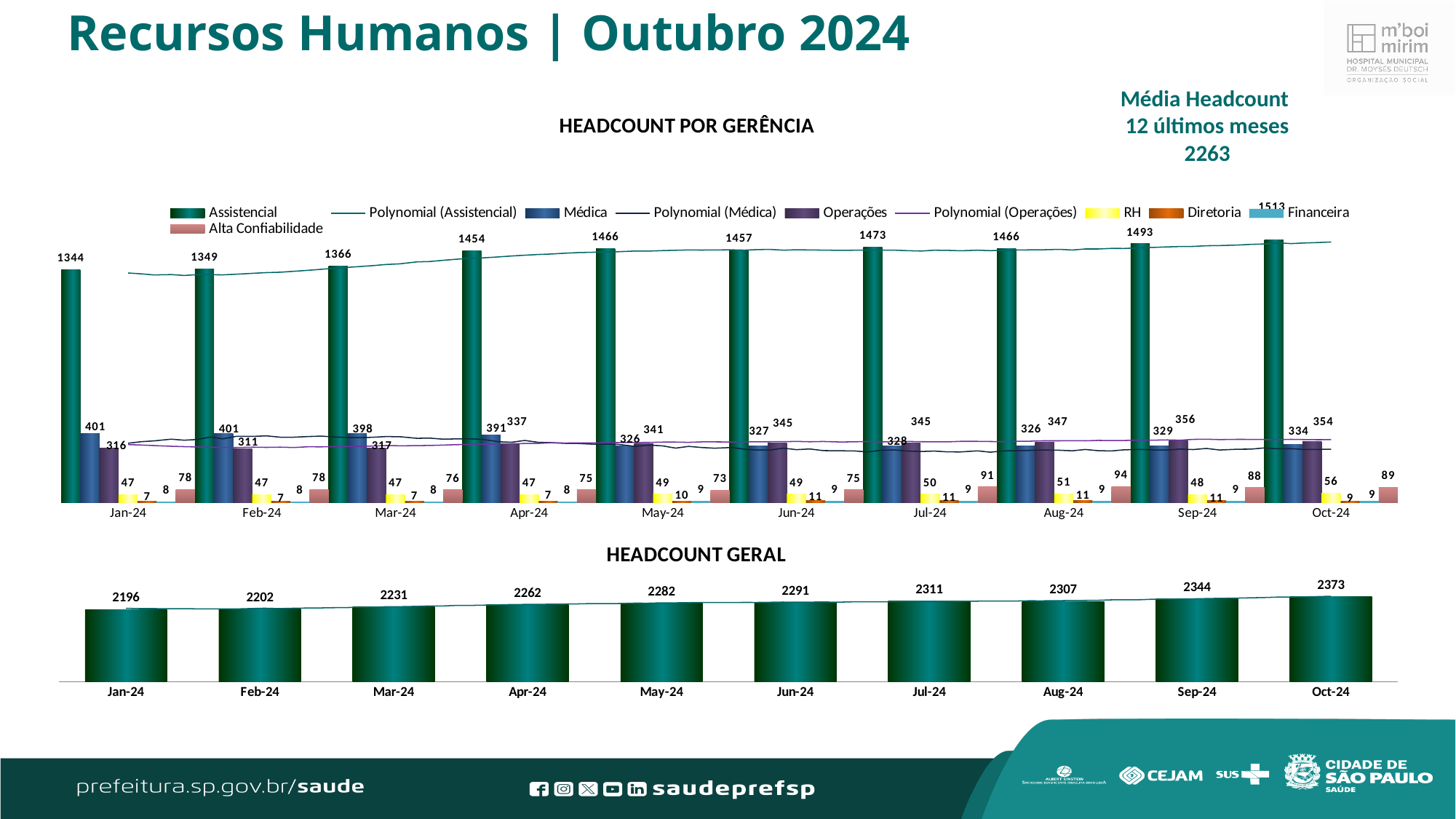
How many months are plotted in the HEADCOUNT GERAL chart? 10 In the HEADCOUNT GERAL chart, which month has the highest headcount? Oct-24 In the HEADCOUNT POR GERÊNCIA chart, what is the Médica value for Jan-24? 401 In the HEADCOUNT POR GERÊNCIA chart, does the Assistencial series generally rise or fall from Jan-24 to Oct-24? rise In the HEADCOUNT GERAL chart, which is larger, Jul-24 or Aug-24? Jul-24 In the HEADCOUNT POR GERÊNCIA chart, what is the Assistencial value for Oct-24? 1513 How many entries does the legend of the HEADCOUNT POR GERÊNCIA chart list? 10 In the HEADCOUNT POR GERÊNCIA chart, which is larger in May-24, Médica or Operações? Operações In the HEADCOUNT GERAL chart, what is the difference between the Oct-24 and Jan-24 values? 177 In the HEADCOUNT GERAL chart, which month has the lowest headcount? Jan-24 In the HEADCOUNT GERAL chart, what is the value for Oct-24? 2373 In the HEADCOUNT POR GERÊNCIA chart, what is the Alta Confiabilidade value for Aug-24? 94